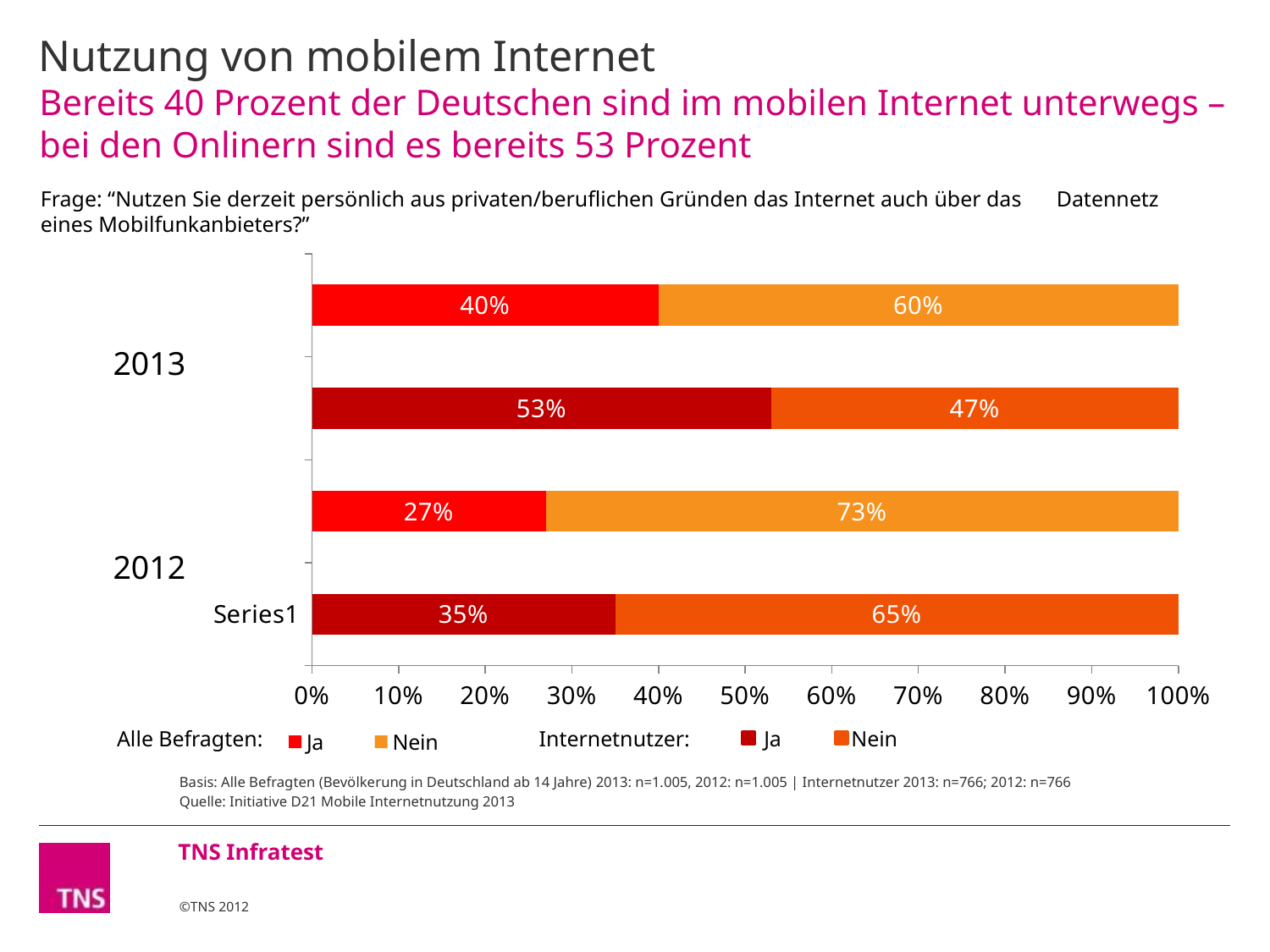
Which year had the lower "Ja" share among Alle Befragten? 2012 How many entries does the legend list in total? 4 What share of Alle Befragten answered "Nein" in 2012? 73% What share of Internetnutzer answered "Ja" in 2013? 53% What is the total of the 2013 Internetnutzer stacked bar (Ja plus Nein)? 100% By how many percentage points did the "Ja" share among Internetnutzer increase from 2012 to 2013? 18 What share of Internetnutzer answered "Nein" in 2012? 65% By how many percentage points did the "Ja" share among Alle Befragten increase from 2012 to 2013? 13 What share of Alle Befragten answered "Ja" in 2013? 40% Is the "Ja" share for Internetnutzer in 2013 greater or less than 50%? greater Which group had the higher "Ja" share in 2013, Alle Befragten or Internetnutzer? Internetnutzer What kind of chart is shown on the slide? Stacked bar chart